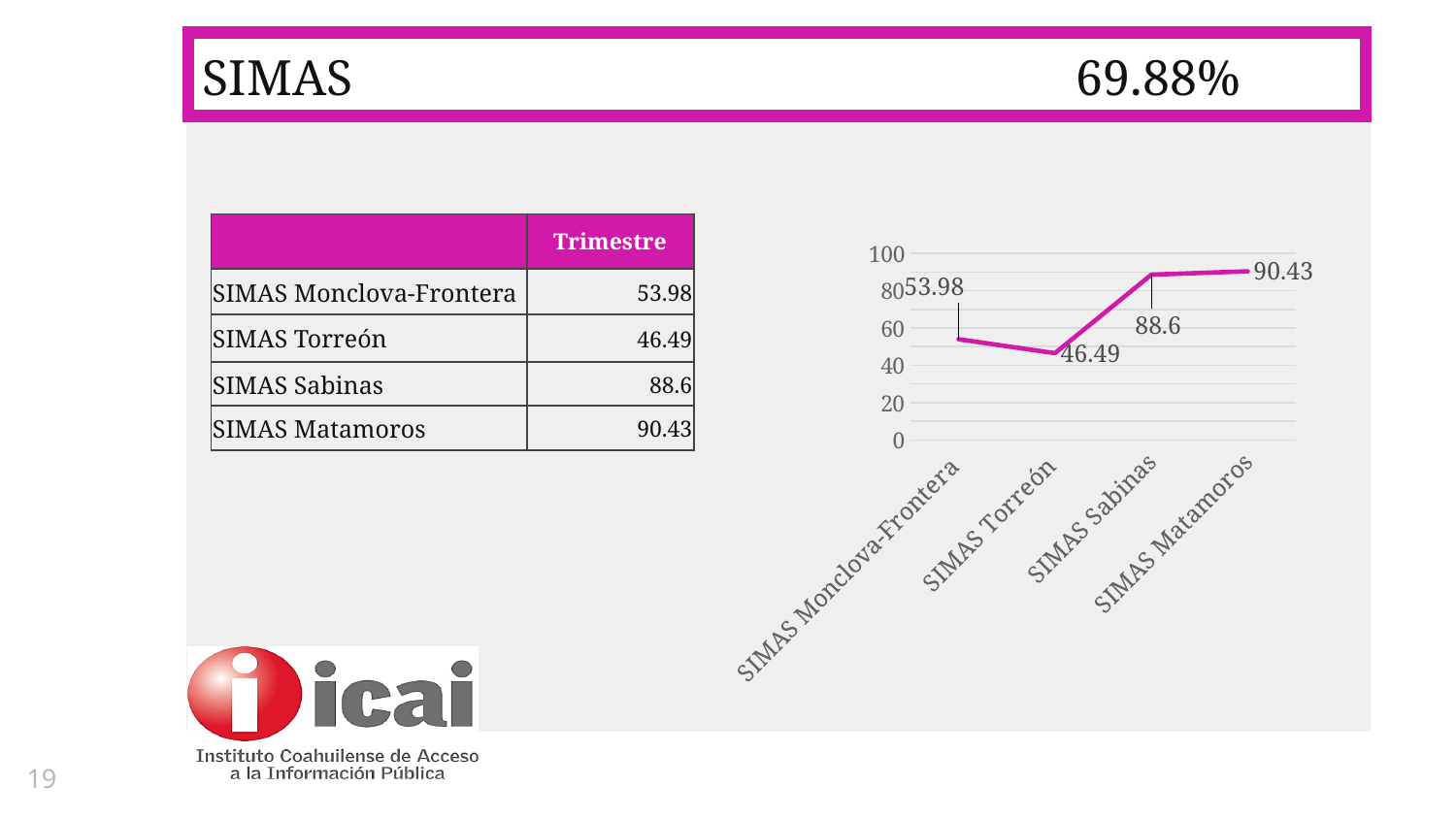
What is the value for SIMAS Monclova-Frontera in the chart? 53.98 Which is larger, the value for SIMAS Sabinas or the value for SIMAS Monclova-Frontera? SIMAS Sabinas What is the value for SIMAS Sabinas in the chart? 88.6 Is the value for SIMAS Torreón greater or less than 60? less Which category has the highest value in the chart? SIMAS Matamoros What is the difference between the values for SIMAS Matamoros and SIMAS Sabinas? 1.83 How many categories are plotted on the x axis of the chart? 4 What is the value for SIMAS Torreón in the chart? 46.49 What kind of chart is shown on the slide? line chart Which category has the lowest value in the chart? SIMAS Torreón What is the difference between the values for SIMAS Monclova-Frontera and SIMAS Torreón? 7.49 What is the value for SIMAS Matamoros in the chart? 90.43